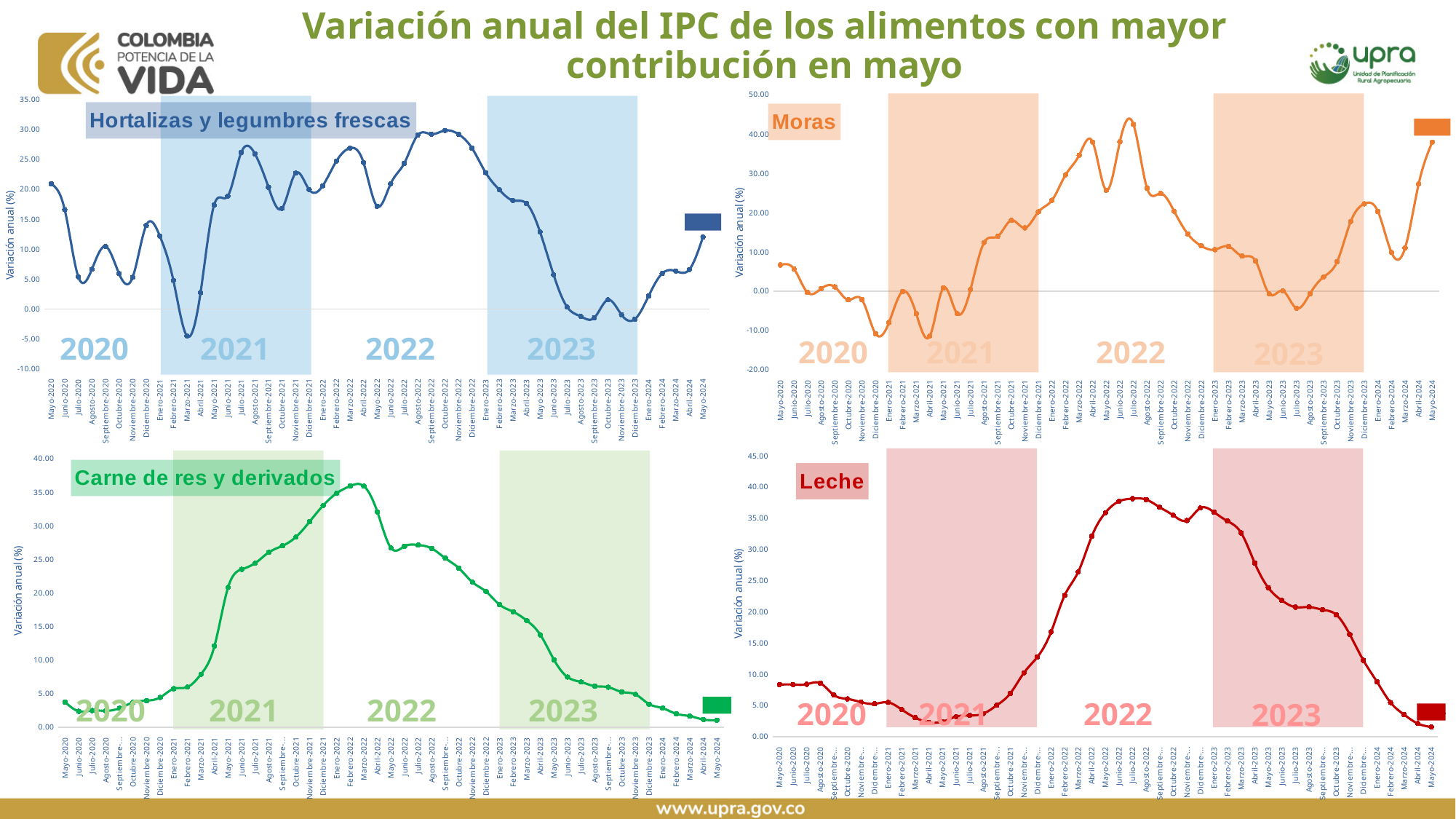
In the 'Hortalizas y legumbres frescas' chart, which is larger, the value for Mayo-2020 or the value for Mayo-2024? Mayo-2020 In the 'Carne de res y derivados' chart, is the value for Mayo-2024 greater or less than 5? less In the 'Moras' chart, in which year does the line reach its highest value? 2022 What is the title of the slide? Variación anual del IPC de los alimentos con mayor contribución en mayo In the 'Carne de res y derivados' chart, do the values rise or fall from Marzo-2022 to Mayo-2024? fall In the 'Hortalizas y legumbres frescas' chart, is the value for Marzo-2021 greater or less than 0? less In the 'Moras' chart, is the value for Mayo-2024 greater or less than 30? greater What colour is the line in the 'Leche' chart? red What kind of chart is the 'Hortalizas y legumbres frescas' chart? line chart In the 'Leche' chart, do the values rise or fall from Julio-2022 to Mayo-2024? fall